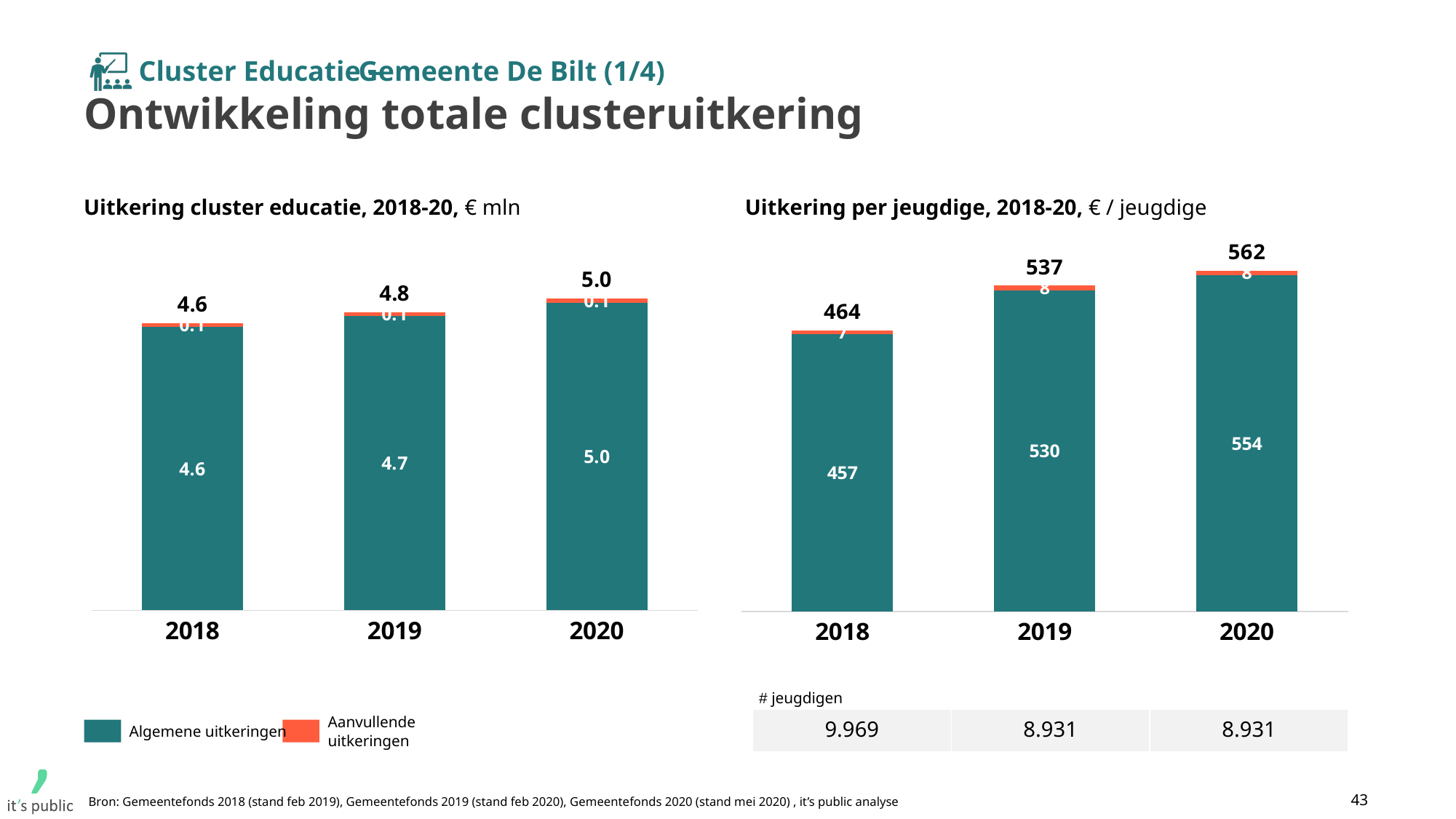
In the chart 'Uitkering per jeugdige, 2018-20', what is the total labelled above the bar for 2018? 464 In the chart 'Uitkering per jeugdige, 2018-20', what is the value of Algemene uitkeringen for 2020? 554 How many years are shown on the x axis of the chart 'Uitkering cluster educatie, 2018-20'? 3 In the chart 'Uitkering cluster educatie, 2018-20', which year has the lowest total? 2018 In the chart 'Uitkering cluster educatie, 2018-20', what is the total value labelled above the bar for 2020? 5.0 In the chart 'Uitkering per jeugdige, 2018-20', do the totals rise or fall from 2018 to 2020? rise How many series does the legend list for the charts on this slide? 2 In the chart 'Uitkering per jeugdige, 2018-20', which year has the highest total? 2020 What kind of chart is 'Uitkering per jeugdige, 2018-20'? stacked bar chart In the chart 'Uitkering cluster educatie, 2018-20', what is the value of Algemene uitkeringen for 2019? 4.7 In the chart 'Uitkering per jeugdige, 2018-20', is the Algemene uitkeringen value for 2019 larger or smaller than for 2018? larger In the chart 'Uitkering per jeugdige, 2018-20', what is the difference between the totals for 2020 and 2018? 98